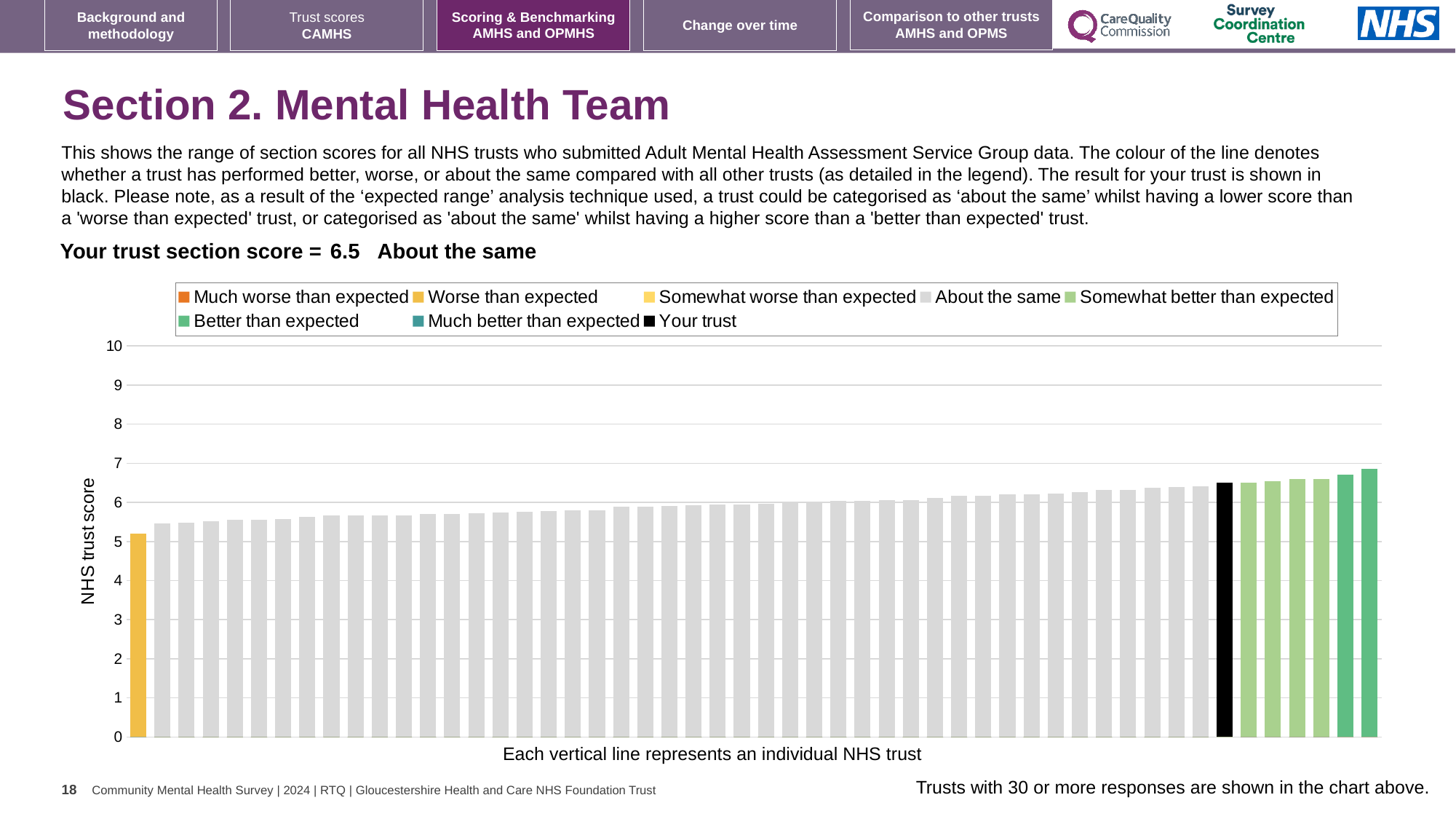
Which category is your trust placed in for this section? About the same Is the value of the rightmost bar greater or less than 7? less Which legend category does the lowest-scoring trust (leftmost bar) belong to? Worse than expected What colour is used in the chart to show your trust? black What kind of chart is shown on the slide? bar chart How many entries does the chart legend list? 8 Is the value of the leftmost bar greater or less than 6? less Which legend category does the highest-scoring trust (rightmost bar) belong to? Better than expected Do the bar values rise or fall from left to right across the chart? rise What is the label on the vertical axis of the chart? NHS trust score Is the value of the black bar (your trust) greater or less than 6? greater What is the section score for your trust shown on the slide? 6.5